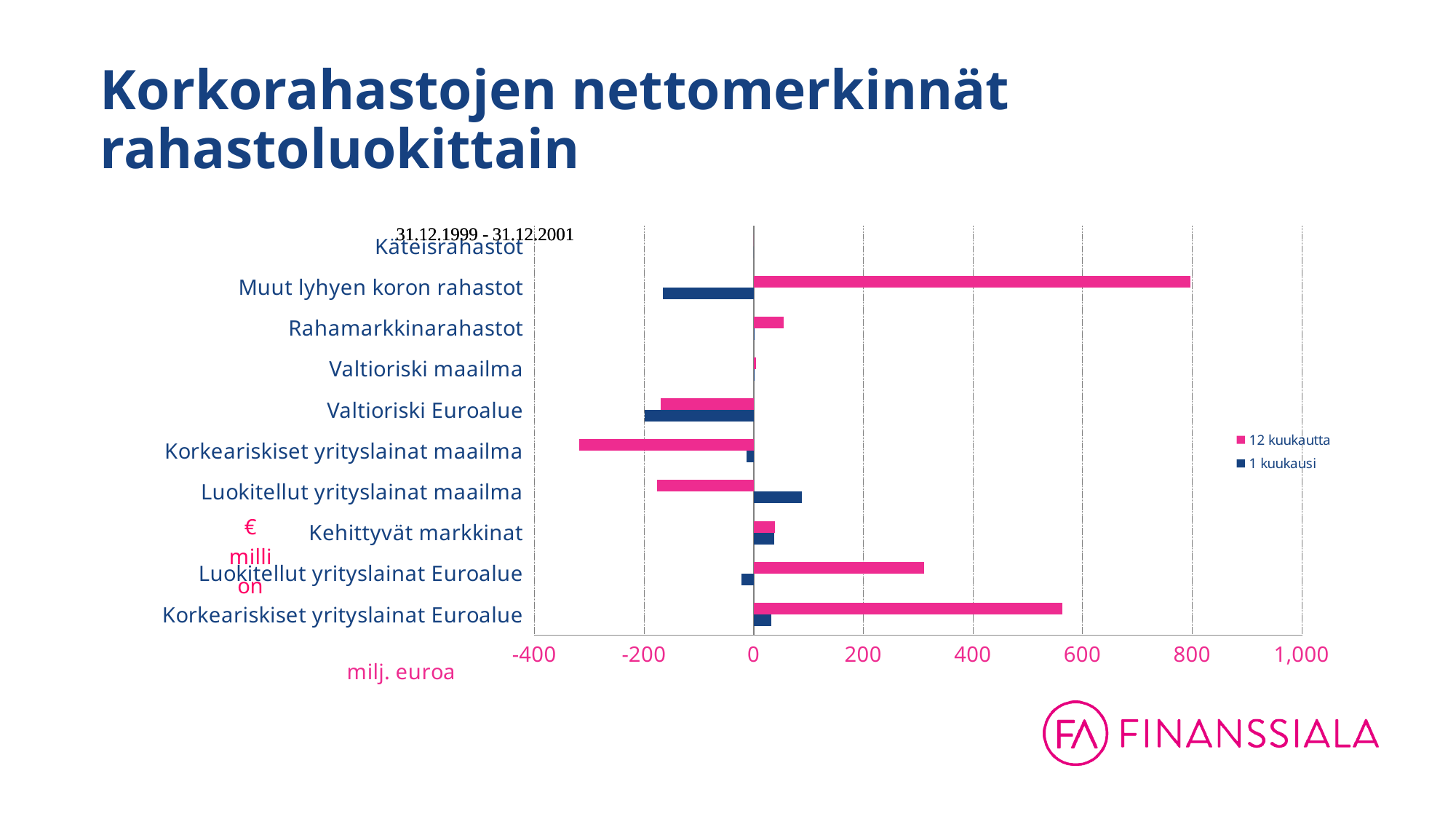
Is the 12 kuukautta value for Luokitellut yrityslainat Euroalue greater or less than 200? greater For the 12 kuukautta series, which is larger: Korkeariskiset yrityslainat Euroalue or Luokitellut yrityslainat Euroalue? Korkeariskiset yrityslainat Euroalue What unit is shown below the horizontal axis? milj. euroa Is the 1 kuukausi value for Luokitellut yrityslainat maailma greater or less than 200? less Is the 12 kuukautta value for Korkeariskiset yrityslainat maailma greater or less than -200? less How many fund categories are listed on the vertical axis? 10 Which category has the highest 12 kuukautta value? Muut lyhyen koron rahastot How many series does the legend list? 2 Which category has the lowest 12 kuukautta value? Korkeariskiset yrityslainat maailma What kind of chart is shown on the slide? bar chart